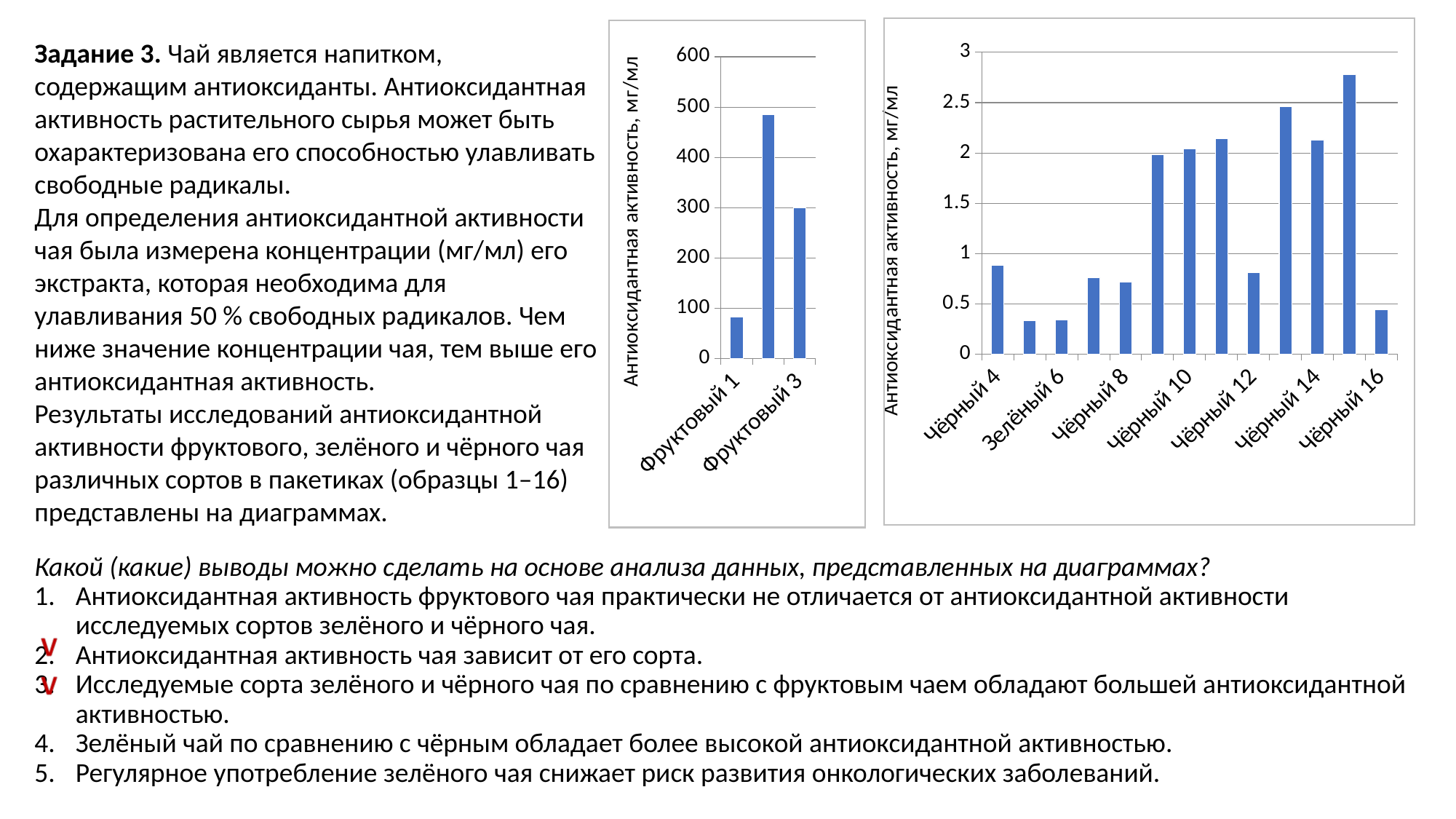
What is the vertical axis title of the right chart? Антиоксидантная активность, мг/мл In the right chart, is the value for Чёрный 8 greater or less than 0.5? greater In the left chart, is the value for Фруктовый 3 greater or less than 200? greater In the left chart, which is larger, Фруктовый 1 or Фруктовый 3? Фруктовый 3 In the left chart, which of the labelled categories, Фруктовый 1 or Фруктовый 3, has the lowest value? Фруктовый 1 In the right chart, is the value for Чёрный 12 greater or less than 1? less In the right chart, which is larger, Чёрный 14 or Чёрный 16? Чёрный 14 How many bars does the right chart (Чёрный/Зелёный) show? 13 How many bars does the left chart (Фруктовый) show? 3 What kind of chart is the left chart (Фруктовый)? bar chart